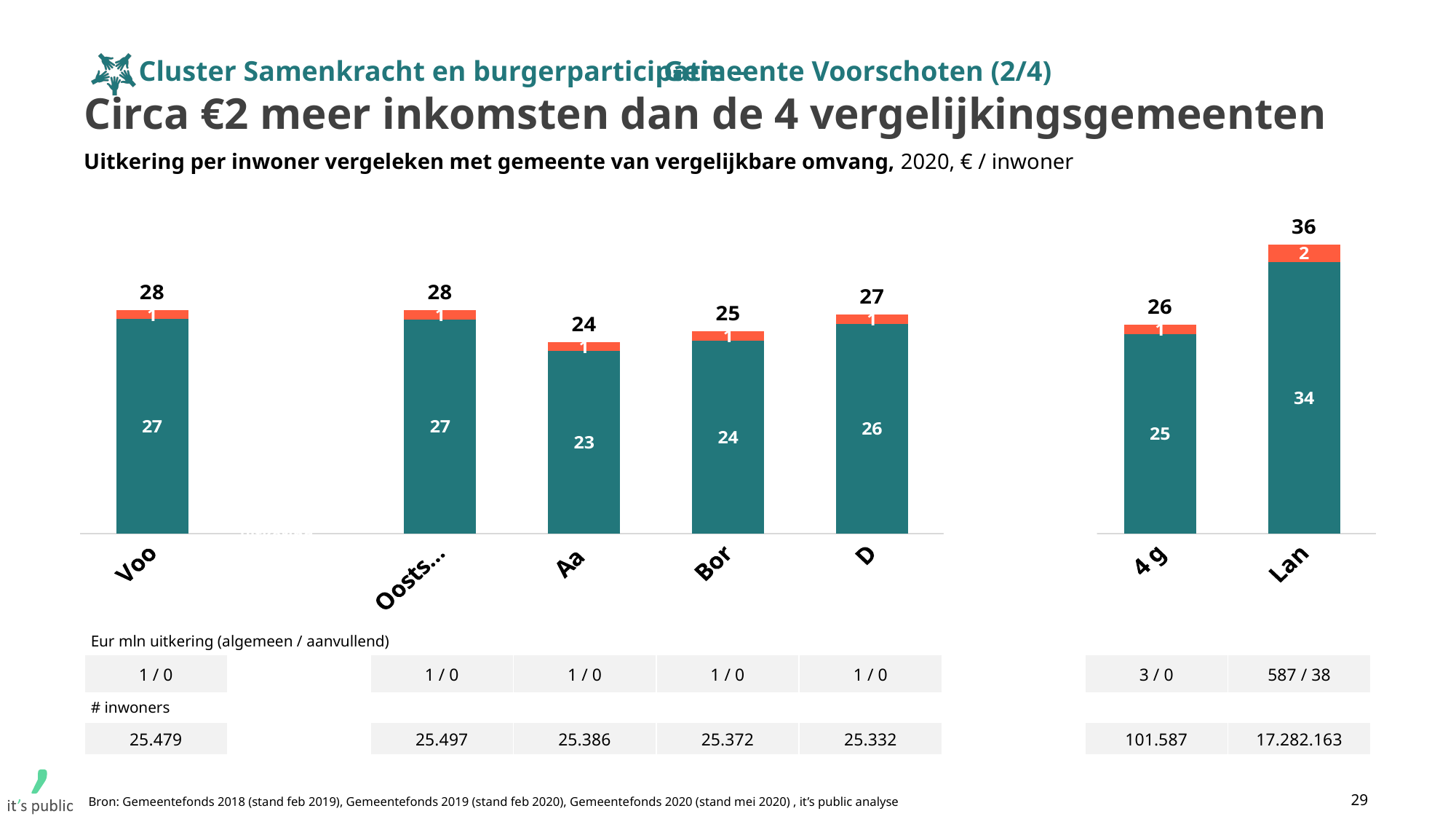
What type of chart is shown on the slide? Stacked bar chart What is the total of the stacked bar for 4 g? 26 What is the total value of the bar for Voo? 28 What is the value of the orange (upper) segment of the bar for Lan? 2 What is the difference between the total for Lan and the total for Voo? 8 Which has a larger total value, Bor or D? D Which category has the highest total value? Lan What is the total value of the bar for Lan? 36 What is the value of the teal (lower) segment of the bar for D? 26 How many bars are shown in the chart? 7 What is the value of the teal (lower) segment of the bar for Aa? 23 Which category has the lowest total value? Aa